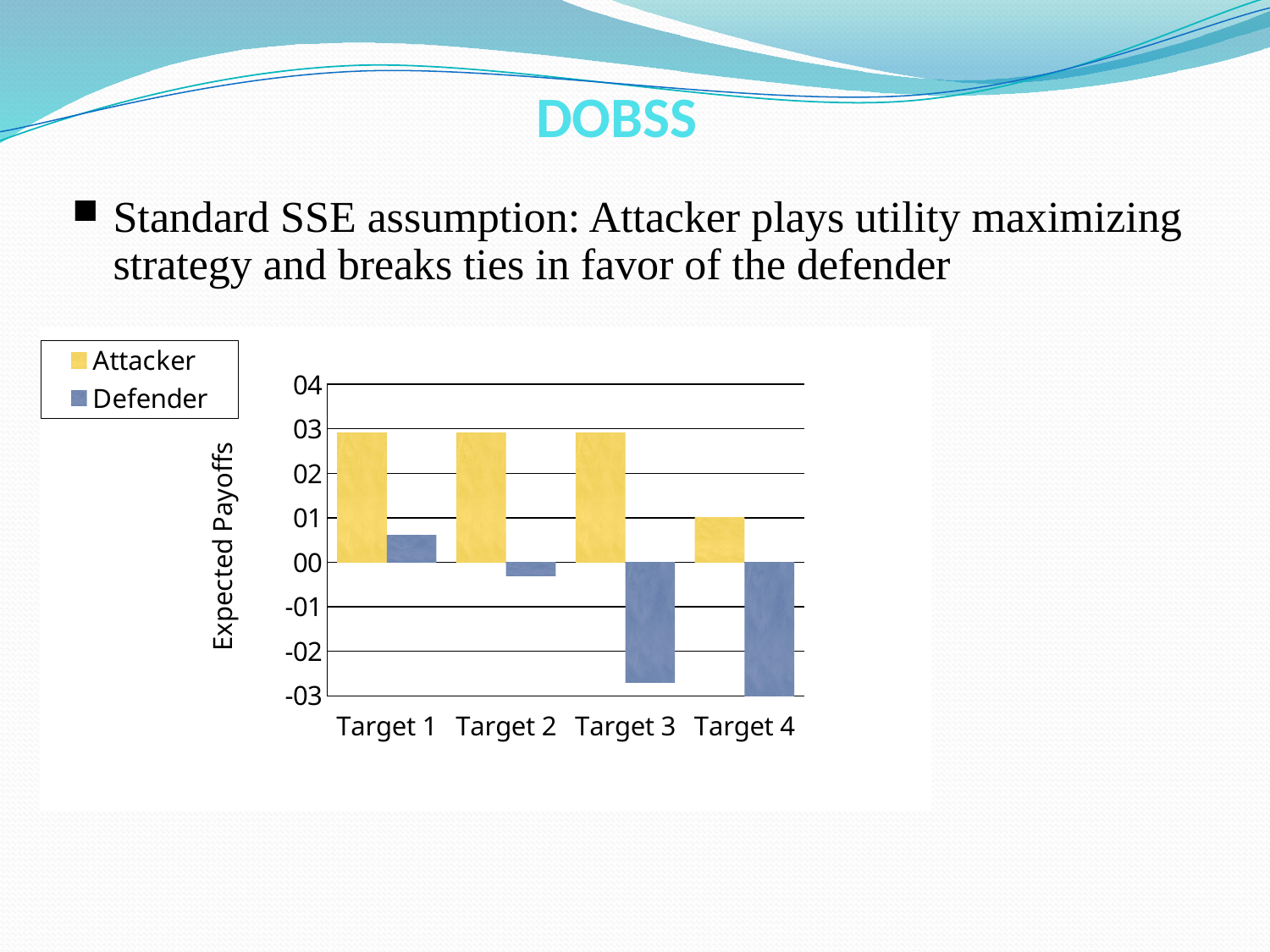
Is the Defender value for Target 2 greater or less than 00? less Is the Defender value for Target 1 greater or less than 00? greater What kind of chart is shown on the slide? bar chart How many targets are shown on the x axis? 4 For which target is the Attacker expected payoff lowest? Target 4 How many series does the legend list? 2 Which colour represents the Attacker series in the legend? yellow What is the label of the vertical axis? Expected Payoffs Is the Attacker value for Target 1 greater or less than 02? greater Which is larger, the Attacker value for Target 1 or the Attacker value for Target 4? Target 1 For which target is the Defender expected payoff highest? Target 1